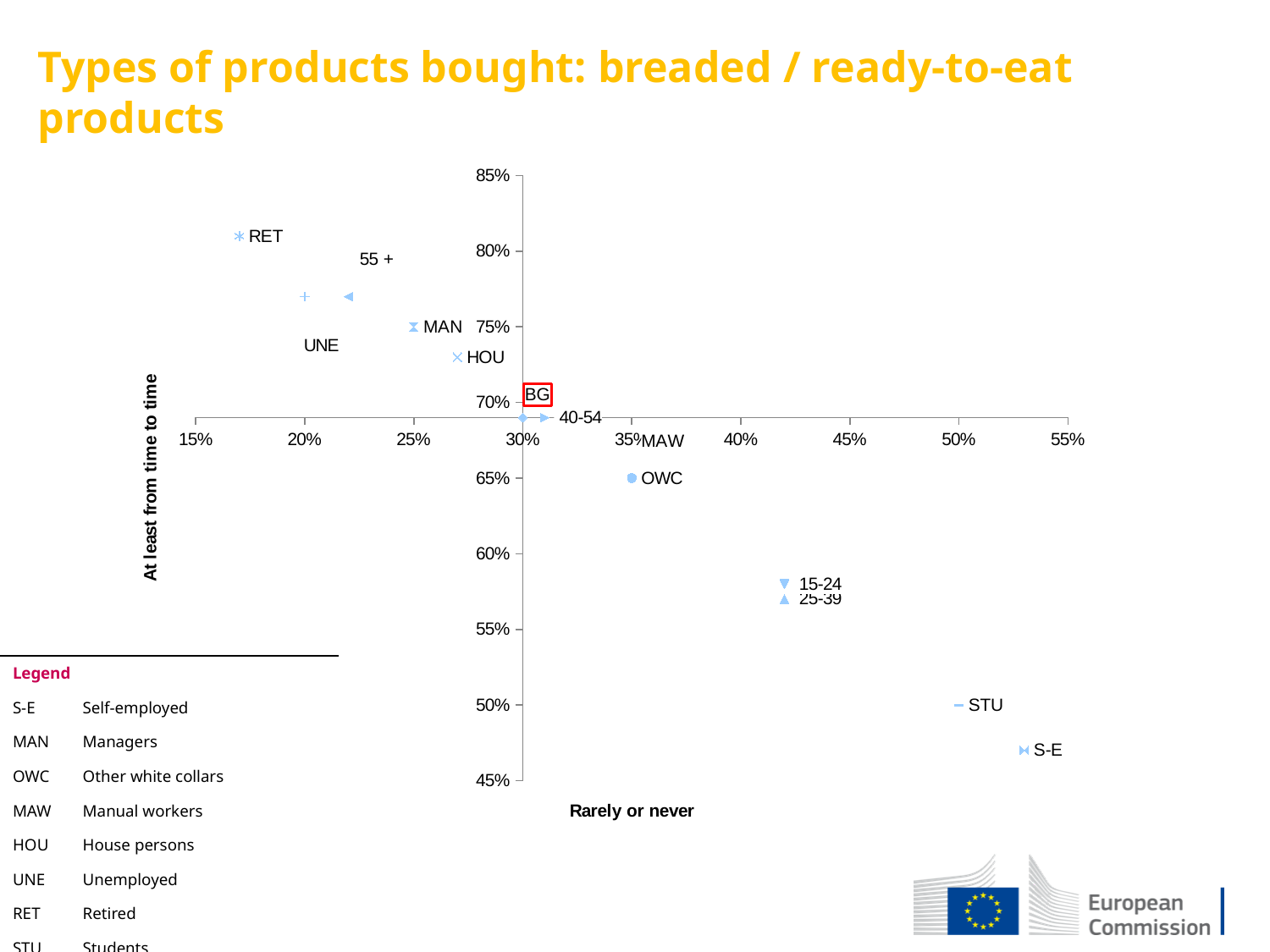
What kind of chart is shown on the slide? scatter chart Which has a higher 'At least from time to time' value, RET or STU? RET Is the 'Rarely or never' value for STU greater or less than 45%? greater Which labelled point has the highest value on the horizontal axis (Rarely or never)? S-E Is the 'At least from time to time' value for OWC greater or less than 70%? less What is the title of the chart on the slide? Types of products bought: breaded / ready-to-eat products What is the label of the horizontal axis? Rarely or never Is the 'Rarely or never' value for MAN greater or less than 30%? less As the 'Rarely or never' value increases along the x axis, do the 'At least from time to time' values of the points rise or fall? fall Which labelled point has the lowest value on the vertical axis (At least from time to time)? S-E Which labelled point has the highest value on the vertical axis (At least from time to time)? RET